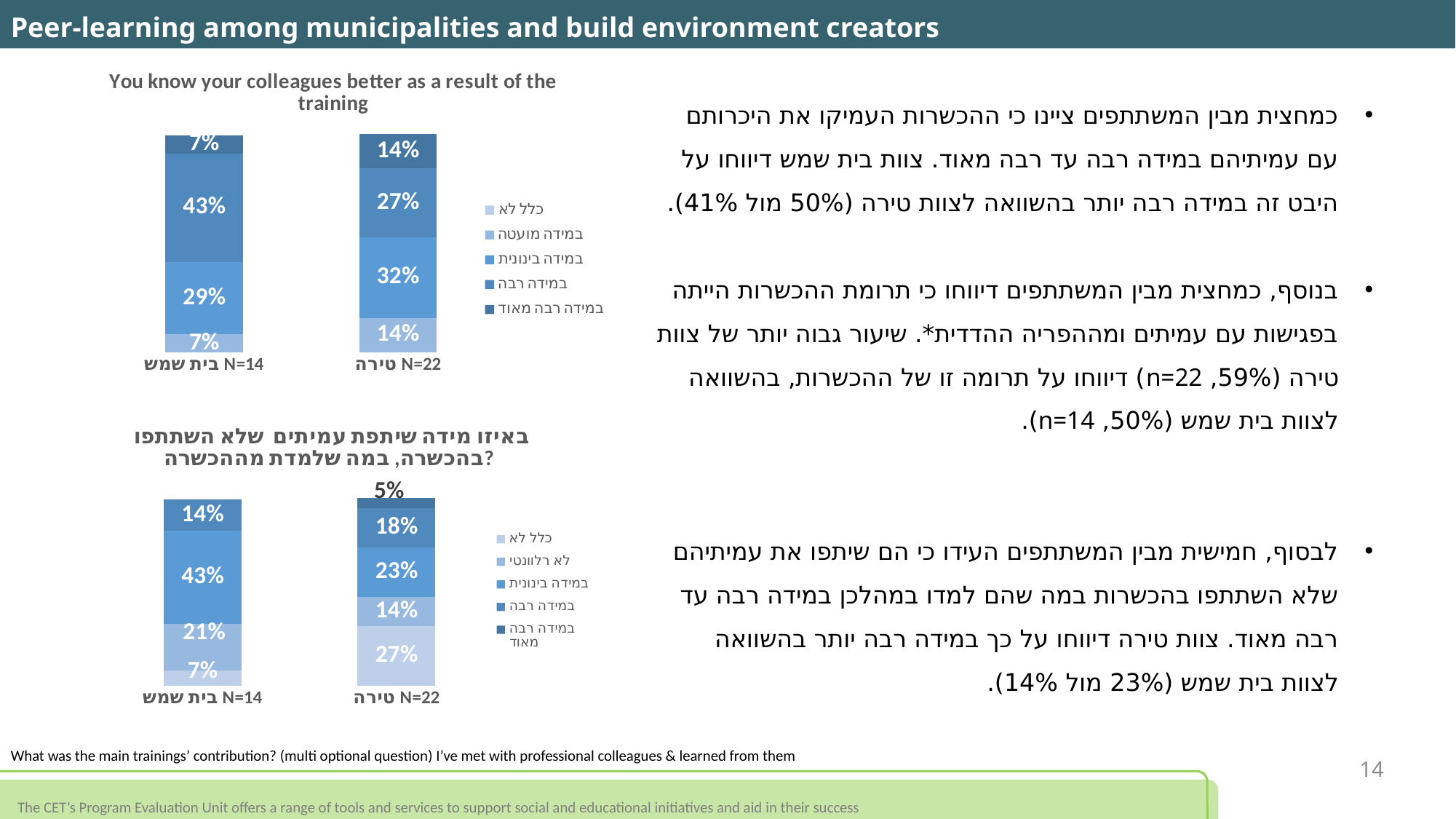
In the top chart 'You know your colleagues better as a result of the training', what is the value of the largest segment in the בית שמש bar? 43% What type of chart is the bottom chart on the slide? Stacked bar chart How many bars (categories) does each of the two charts on the slide show? 2 In the top chart 'You know your colleagues better as a result of the training', how many entries does the legend list? 5 In the top chart 'You know your colleagues better as a result of the training', what is the value of the topmost (darkest) segment of the טירה bar? 14% In the bottom chart, what is the value of the bottom (lightest) segment of the טירה bar? 27% In the bottom chart, what is the value of the largest segment in the בית שמש bar? 43% In the top chart 'You know your colleagues better as a result of the training', what is the sample size (N) shown for טירה? 22 In the top chart 'You know your colleagues better as a result of the training', what is the value of the largest segment in the טירה bar? 32% In the bottom chart, what is the difference between the topmost segment of the בית שמש bar (14%) and the topmost segment of the טירה bar (5%)? 9% In the bottom chart, what is the value of the topmost segment of the טירה bar? 5% In the top chart 'You know your colleagues better as a result of the training', what is the value of the topmost (darkest) segment of the בית שמש bar? 7%